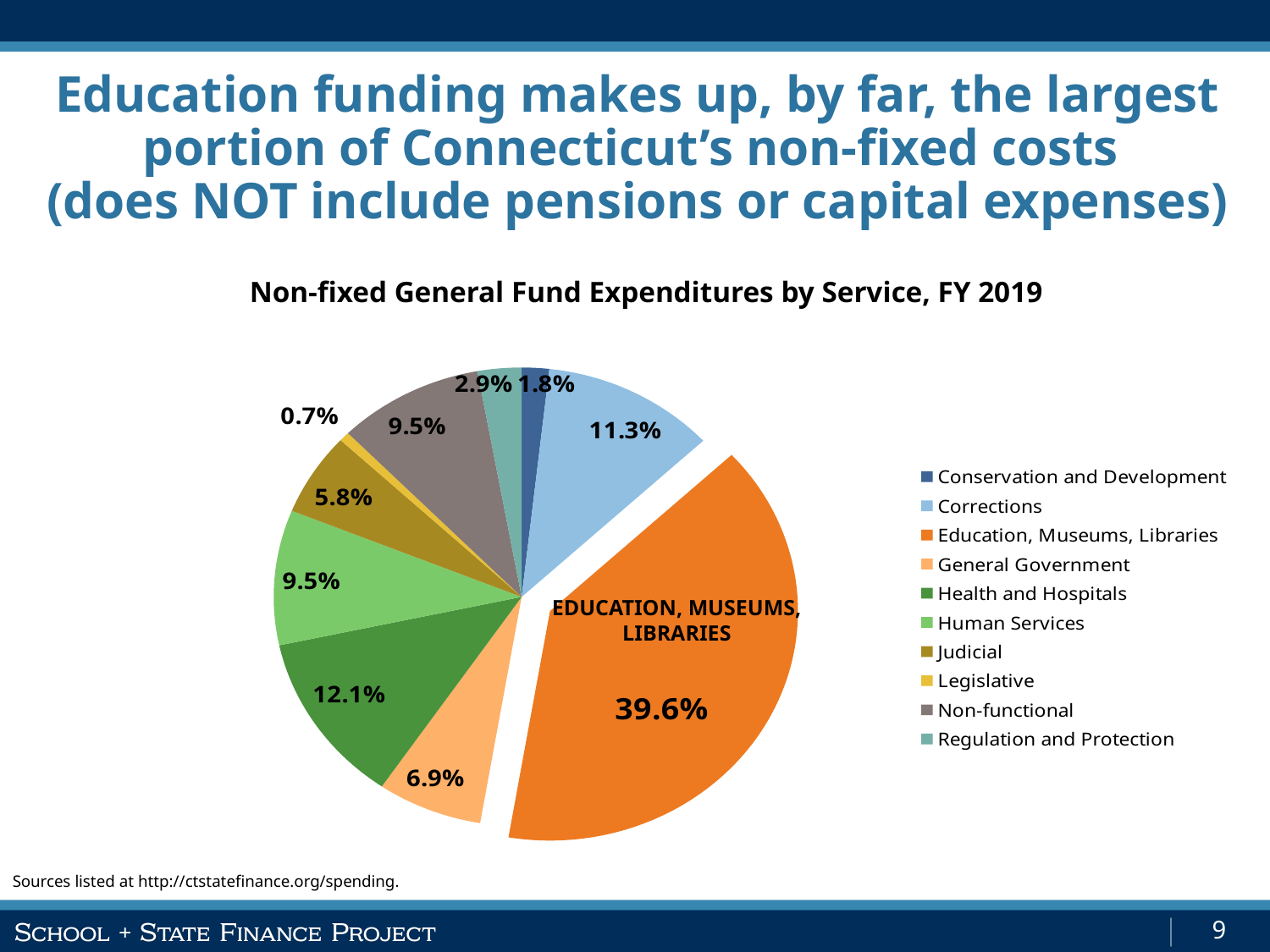
What type of chart is shown on the slide? pie chart How many categories does the legend list? 10 Which category has the smallest share of the pie? Legislative Which category has the largest share of the pie? Education, Museums, Libraries Which is larger, the share for Corrections or the share for Judicial? Corrections What share of non-fixed General Fund expenditures goes to Education, Museums, Libraries? 39.6% What percentage of the pie is General Government? 6.9% What is the difference in percentage points between Education, Museums, Libraries and Health and Hospitals? 27.5 What is the title of the chart? Non-fixed General Fund Expenditures by Service, FY 2019 What colour is the Education, Museums, Libraries slice? orange What percentage of the pie is Health and Hospitals? 12.1% What percentage of the pie is Corrections? 11.3%